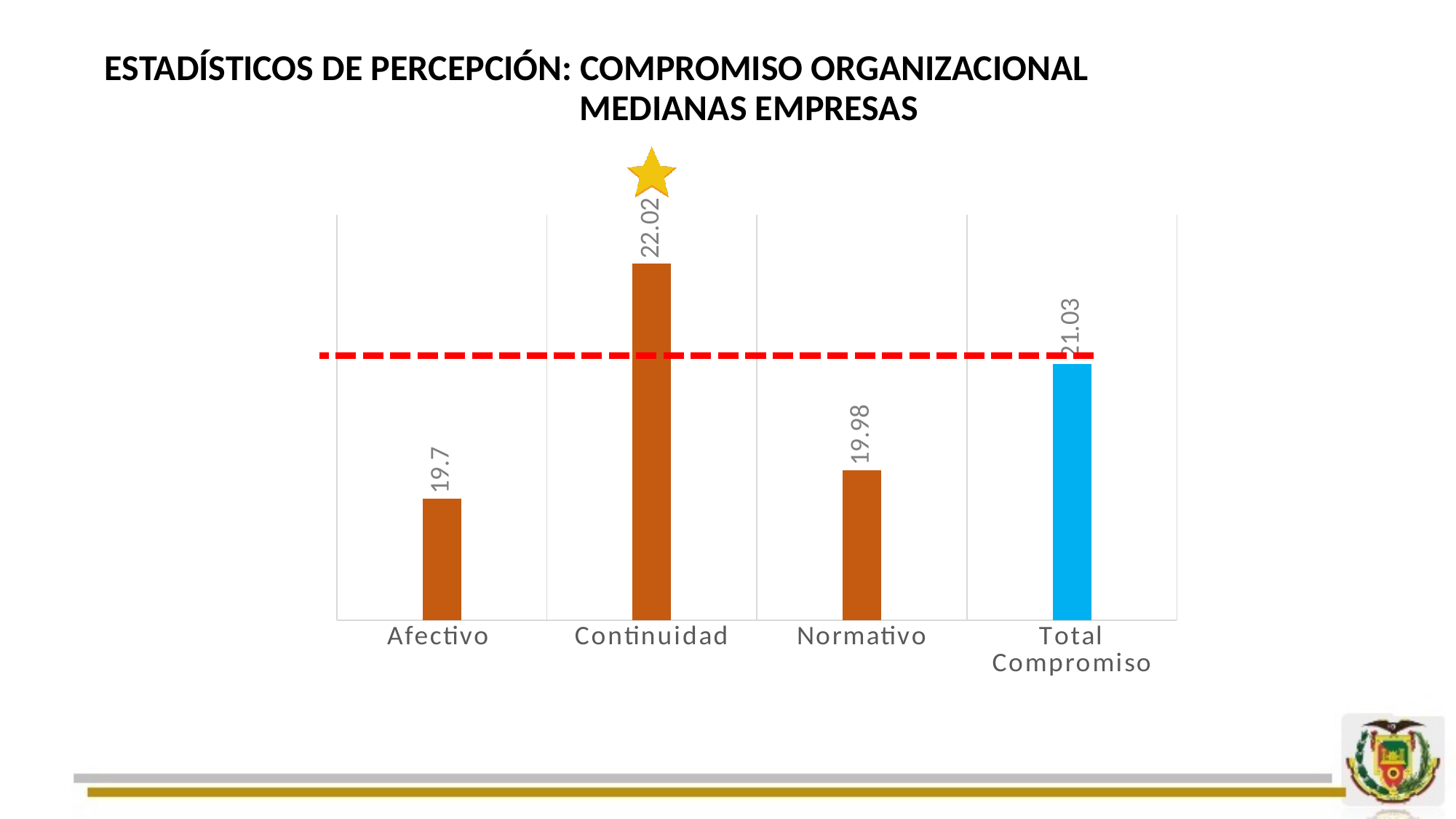
What is the value for Normativo? 19.98 What is the difference between the values for Total Compromiso and Normativo? 1.05 Which bar is coloured blue rather than orange? Total Compromiso What is the value for Continuidad? 22.02 What is the value for Total Compromiso? 21.03 How many categories are shown on the x axis? 4 Which category has the highest value? Continuidad What is the difference between the values for Continuidad and Afectivo? 2.32 What is the value for Afectivo? 19.7 Which category has the lowest value? Afectivo Which is larger, the value for Continuidad or the value for Total Compromiso? Continuidad What kind of chart is shown on the slide? Bar chart